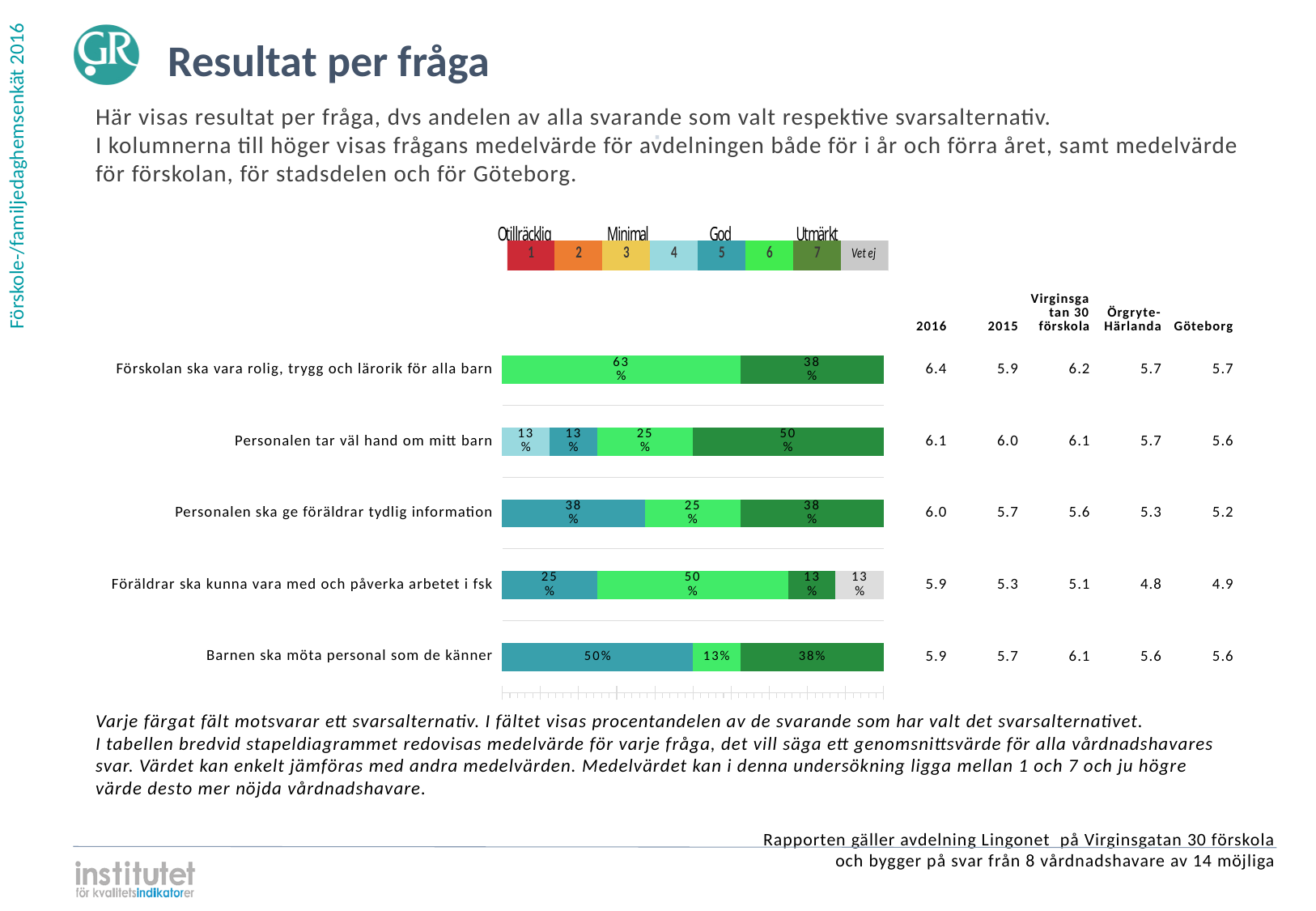
What percentage of respondents chose 6 for 'Förskolan ska vara rolig, trygg och lärorik för alla barn'? 63% For 'Personalen ska ge föräldrar tydlig information', which is larger: the share choosing 5 or the share choosing 6? 5 (38%) Which question has the largest share of respondents choosing 7 (Utmärkt)? Personalen tar väl hand om mitt barn What percentage of respondents chose 5 (God) for 'Barnen ska möta personal som de känner'? 50% How many questions (categories) are plotted in the bar chart? 5 What percentage of respondents chose 7 (Utmärkt) for 'Personalen tar väl hand om mitt barn'? 50% What kind of chart is shown on the slide? Stacked bar chart What is the 2016 mean value shown for 'Förskolan ska vara rolig, trygg och lärorik för alla barn'? 6.4 How many entries does the colour legend above the chart list? 8 For 'Förskolan ska vara rolig, trygg och lärorik för alla barn', what is the difference between the share choosing 6 and the share choosing 7? 25% What label does the legend give to the rating value 7? Utmärkt What percentage of respondents answered 'Vet ej' for 'Föräldrar ska kunna vara med och påverka arbetet i fsk'? 13%